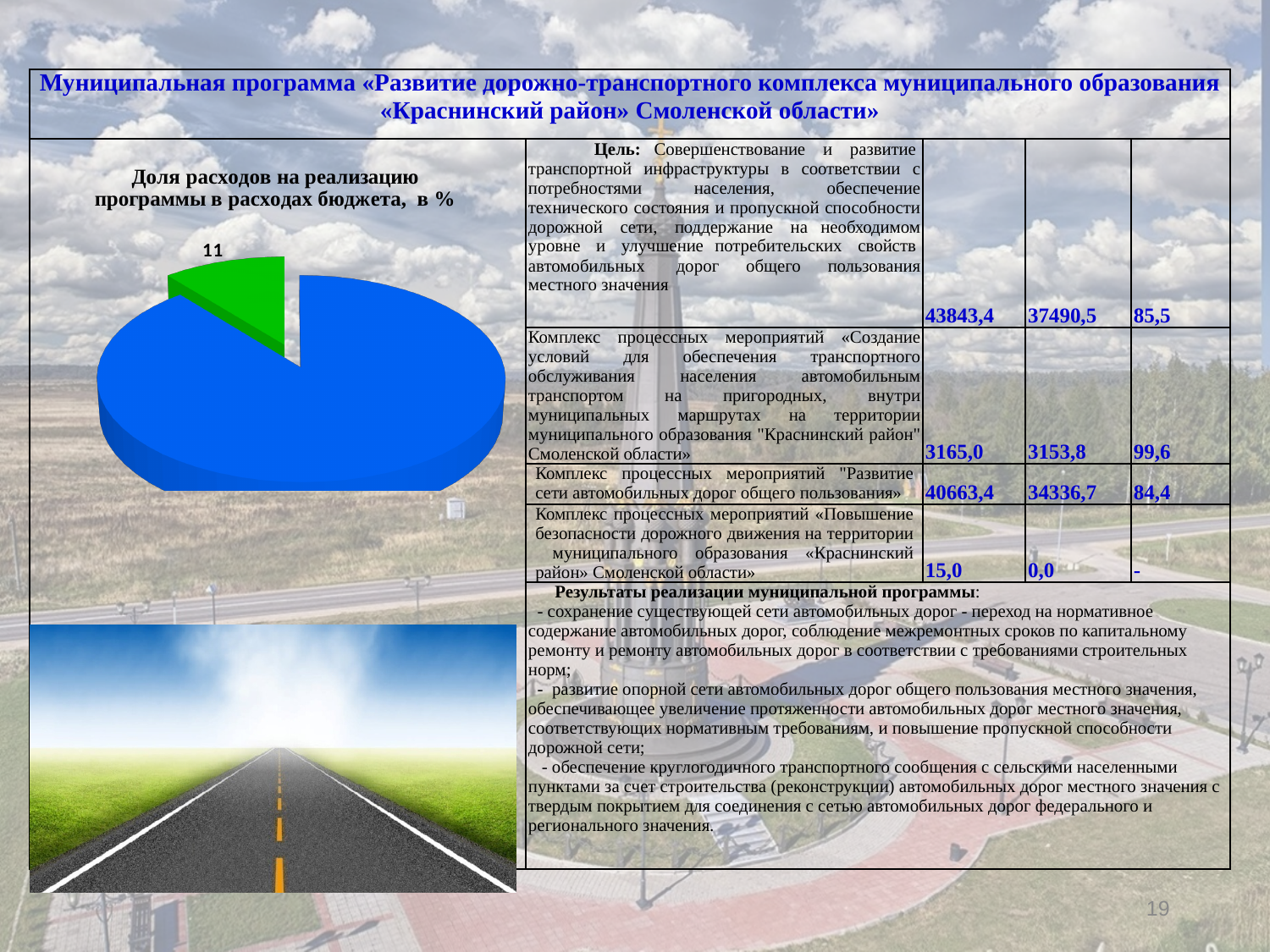
Which slice of the pie chart is the largest? the blue slice What kind of chart is shown on the slide? pie chart What colour is the largest slice of the pie chart? blue Which slice of the pie chart is the smallest? the green slice What share of the pie does the green slice represent, according to the data label? 11 What value is printed on the green slice of the pie chart? 11 How many slices does the pie chart have? 2 What is the title of the pie chart? Доля расходов на реализацию программы в расходах бюджета, в % Which slice of the pie chart is larger, the blue one or the green one? the blue one